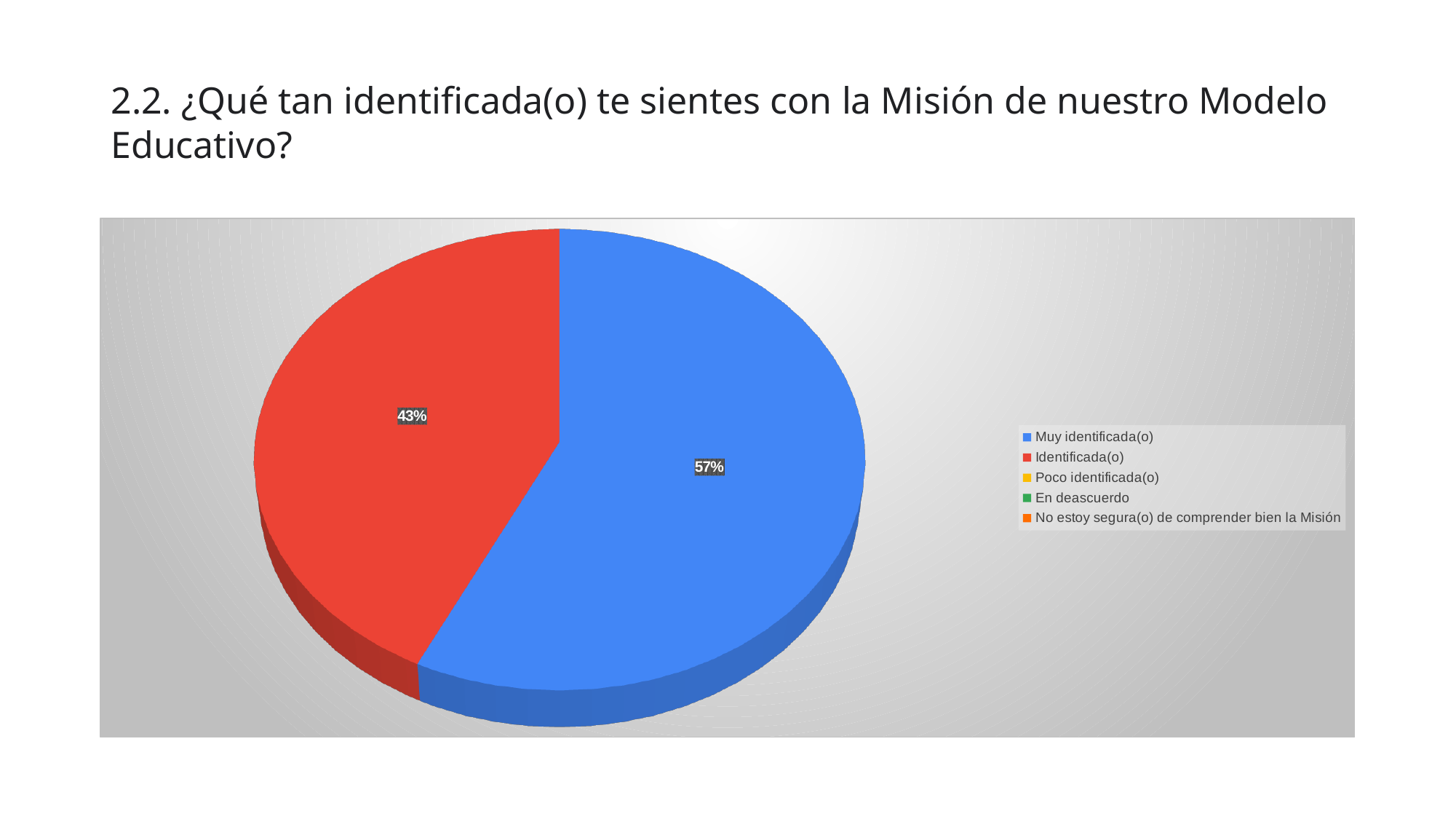
What share of the pie is labelled "Identificada(o)"? 43% How many slices are visible in the pie? 2 Which is larger, the slice for "Muy identificada(o)" or the slice for "Identificada(o)"? Muy identificada(o) What share of the pie is labelled "Muy identificada(o)"? 57% Which category has the largest slice of the pie? Muy identificada(o) What is the difference in percentage points between the "Muy identificada(o)" slice and the "Identificada(o)" slice? 14 What is the title of the slide? 2.2. ¿Qué tan identificada(o) te sientes con la Misión de nuestro Modelo Educativo? What colour is the slice for "Identificada(o)"? red How many entries does the legend list? 5 Is the share for "Muy identificada(o)" greater or less than 50%? greater What kind of chart is shown on the slide? pie chart